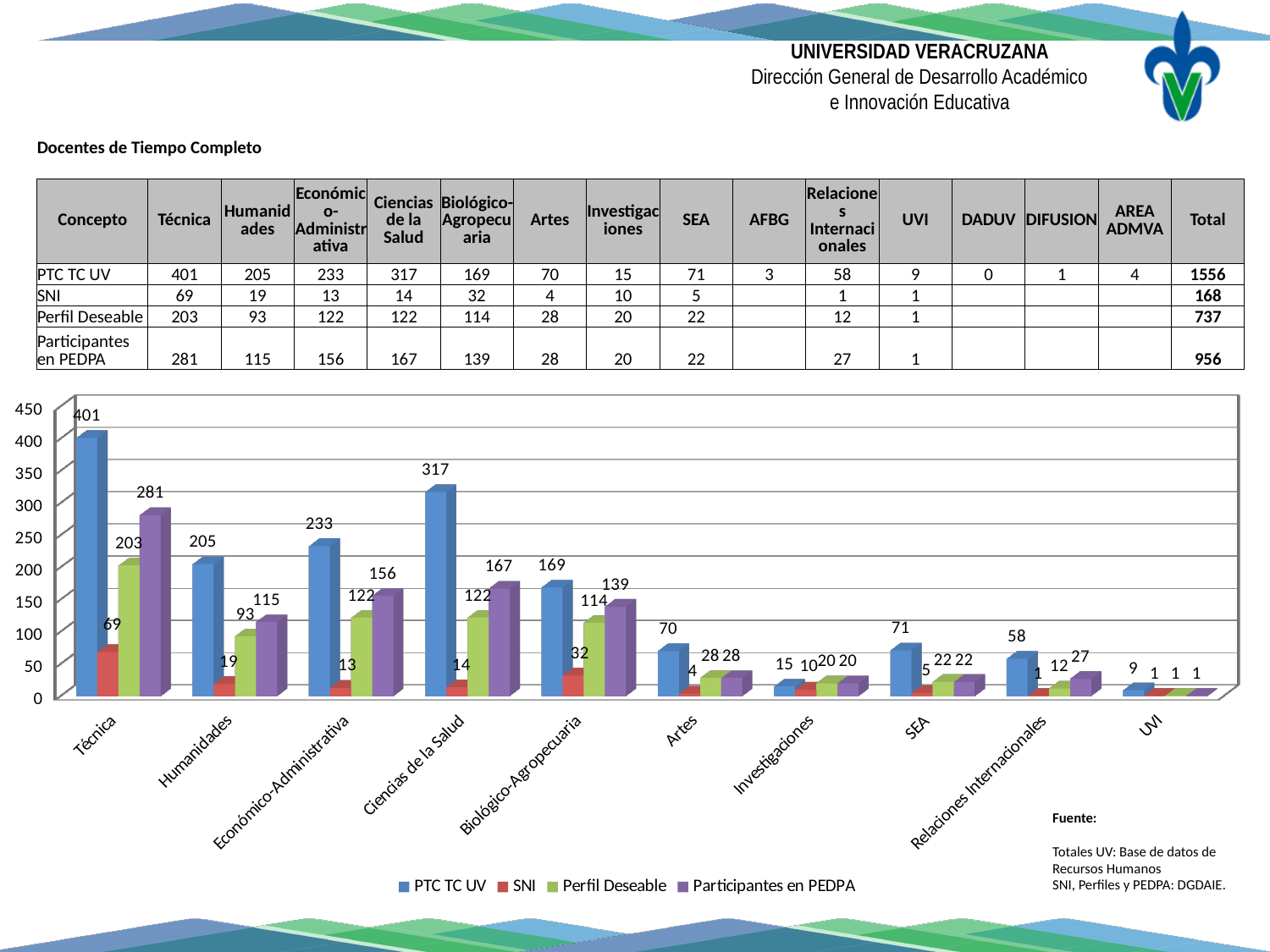
Which is larger for Económico-Administrativa: the Perfil Deseable value or the Participantes en PEDPA value? Participantes en PEDPA What is the SNI value for Biológico-Agropecuaria in the chart? 32 Is the PTC TC UV value for Ciencias de la Salud greater or less than 300? greater How many categories are shown on the x axis of the chart? 10 What kind of chart is shown on the slide? bar chart What is the Participantes en PEDPA value for Ciencias de la Salud in the chart? 167 How many series does the chart legend list? 4 What is the difference between the PTC TC UV value and the Participantes en PEDPA value for Humanidades? 90 Which category has the lowest PTC TC UV value in the chart? UVI What is the PTC TC UV value for Técnica in the chart? 401 Which series is shown in purple in the chart legend? Participantes en PEDPA Which category has the highest PTC TC UV value in the chart? Técnica